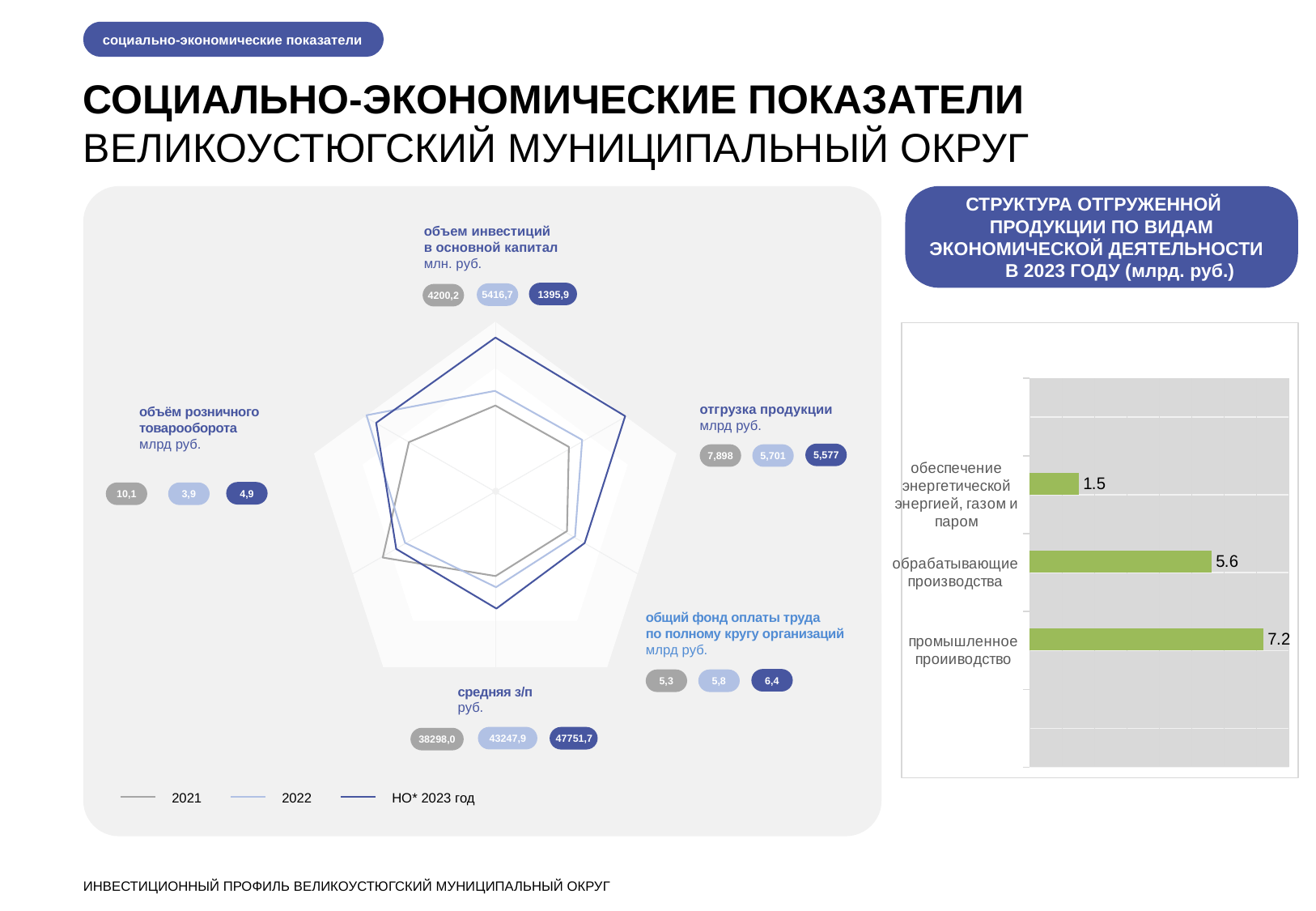
In the radar chart on the left, what is the value of средняя з/п for НО* 2023 год? 47751,7 How many series does the legend of the radar chart on the left list? 3 In the radar chart on the left, how many axes (indicators) are plotted? 5 In the bar chart on the right, what is the value for обрабатывающие производства? 5.6 In the radar chart on the left, which is larger for отгрузка продукции: the 2021 value or the 2022 value? 2021 In the bar chart on the right, what is the value for промышленное проиводство? 7.2 In the radar chart on the left, what is the value of объем инвестиций в основной капитал for 2022? 5416,7 In the bar chart on the right, which category has the highest value? промышленное проиводство What kind of chart is the chart on the right of the slide? bar chart How many categories are shown in the bar chart on the right? 3 In the bar chart on the right, what is the difference between промышленное проиводство and обрабатывающие производства? 1.6 In the bar chart on the right, which category has the lowest value? обеспечение энергетической энергией, газом и паром